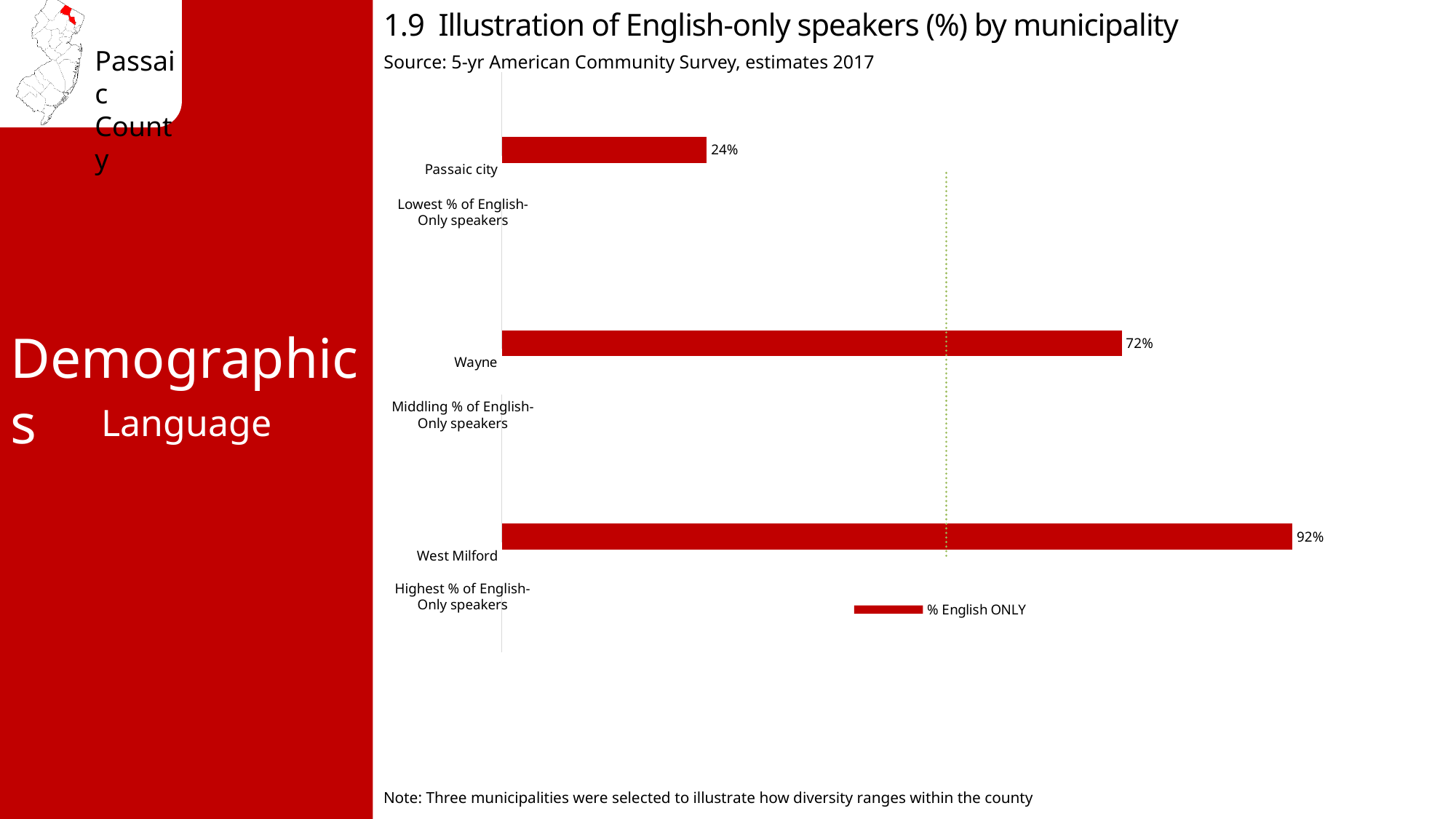
Which has a higher percentage of English-only speakers, Wayne or Passaic city? Wayne What percentage of English-only speakers is shown for Passaic city? 24% How many municipalities are plotted in the chart? 3 Which municipality has the lowest percentage of English-only speakers? Passaic city How many series does the legend list? 1 What percentage of English-only speakers is shown for Wayne? 72% Which municipality has the highest percentage of English-only speakers? West Milford What percentage of English-only speakers is shown for West Milford? 92% What is the difference in percentage points between Wayne and Passaic city? 48 What kind of chart is shown on the slide? Bar chart What is the difference in percentage points between West Milford and Passaic city? 68 What is the legend entry for the series in the chart? % English ONLY